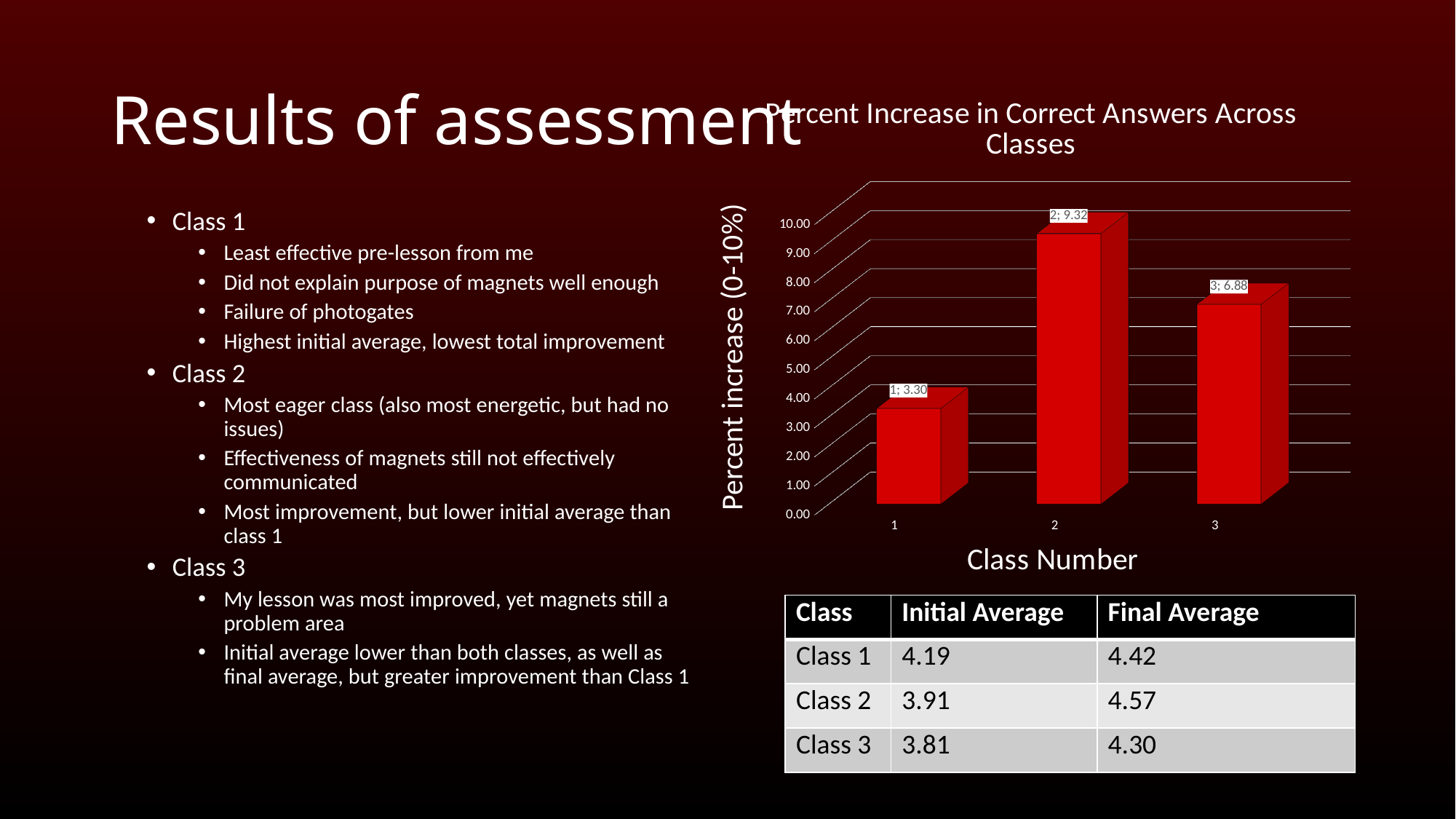
Which class number has the highest percent increase in correct answers? 2 How many class numbers are plotted on the chart? 3 What is the percent increase value shown for class 3? 6.88 Which class number has the lowest percent increase in correct answers? 1 What is the percent increase value shown for class 2? 9.32 What is the title of the chart? Percent Increase in Correct Answers Across Classes What is the difference between the percent increase for class 2 and class 1? 6.02 Which has a larger percent increase, class 3 or class 1? class 3 What kind of chart is shown on the slide? bar chart What is the difference between the percent increase for class 2 and class 3? 2.44 What is the percent increase value shown for class 1? 3.30 Is the value for class 3 greater or less than 5.00? greater